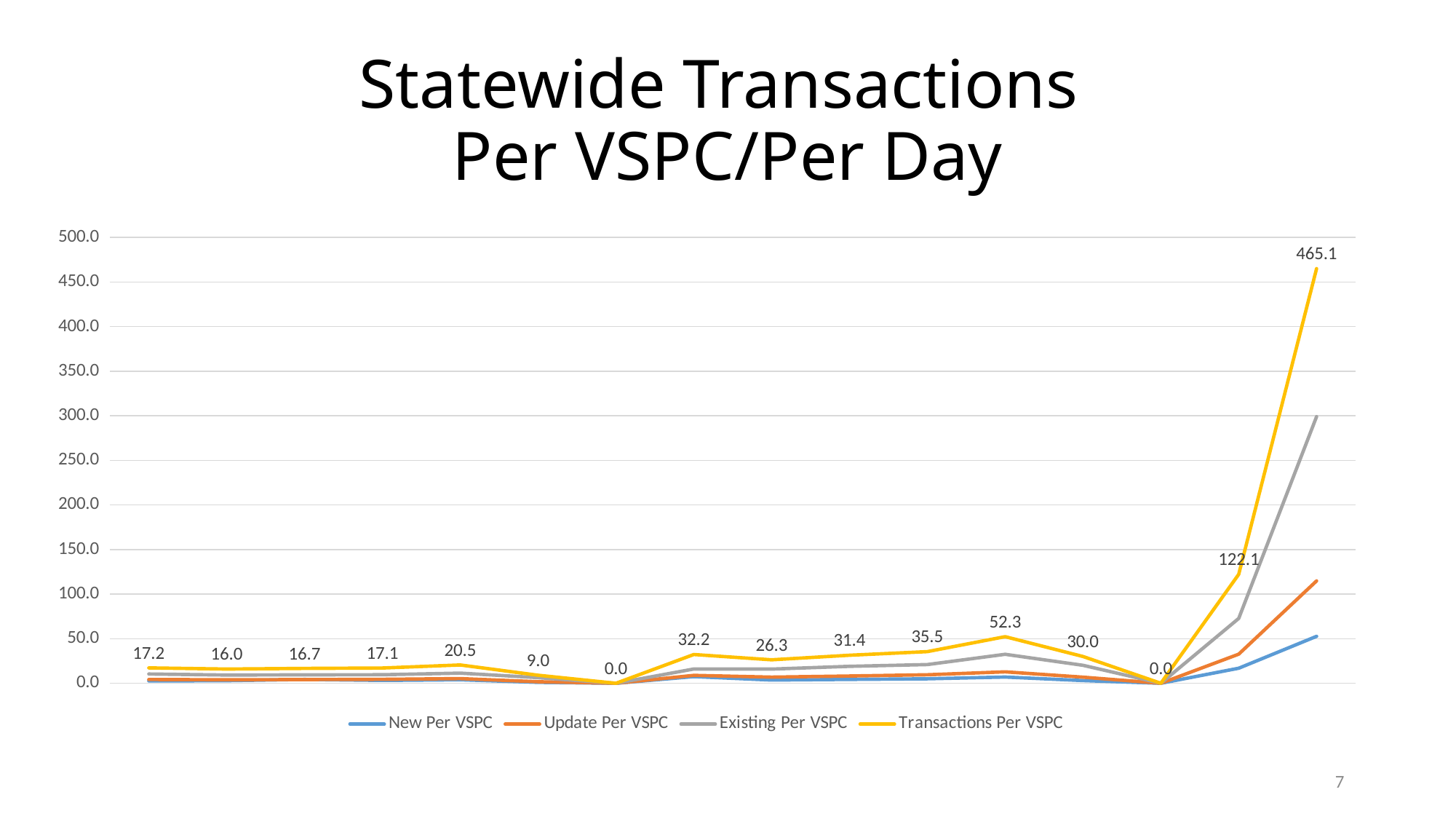
What is the lowest labelled value for the Transactions Per VSPC series? 0.0 What is the highest labelled value for the Transactions Per VSPC series? 465.1 How many data points are plotted for the Transactions Per VSPC series? 16 How many series does the legend list? 4 What colour is the Transactions Per VSPC line in the legend? yellow Which series reaches the highest value at the final point on the x axis? Transactions Per VSPC Is the final value of the New Per VSPC series greater or less than 100.0? less What is the labelled value of the second-to-last point of the Transactions Per VSPC series? 122.1 What kind of chart is shown on the slide? line chart Is the final value of the Existing Per VSPC series greater or less than 250.0? greater What is the labelled value of the first point of the Transactions Per VSPC series? 17.2 What is the difference between the last two labelled values of the Transactions Per VSPC series (465.1 and 122.1)? 343.0